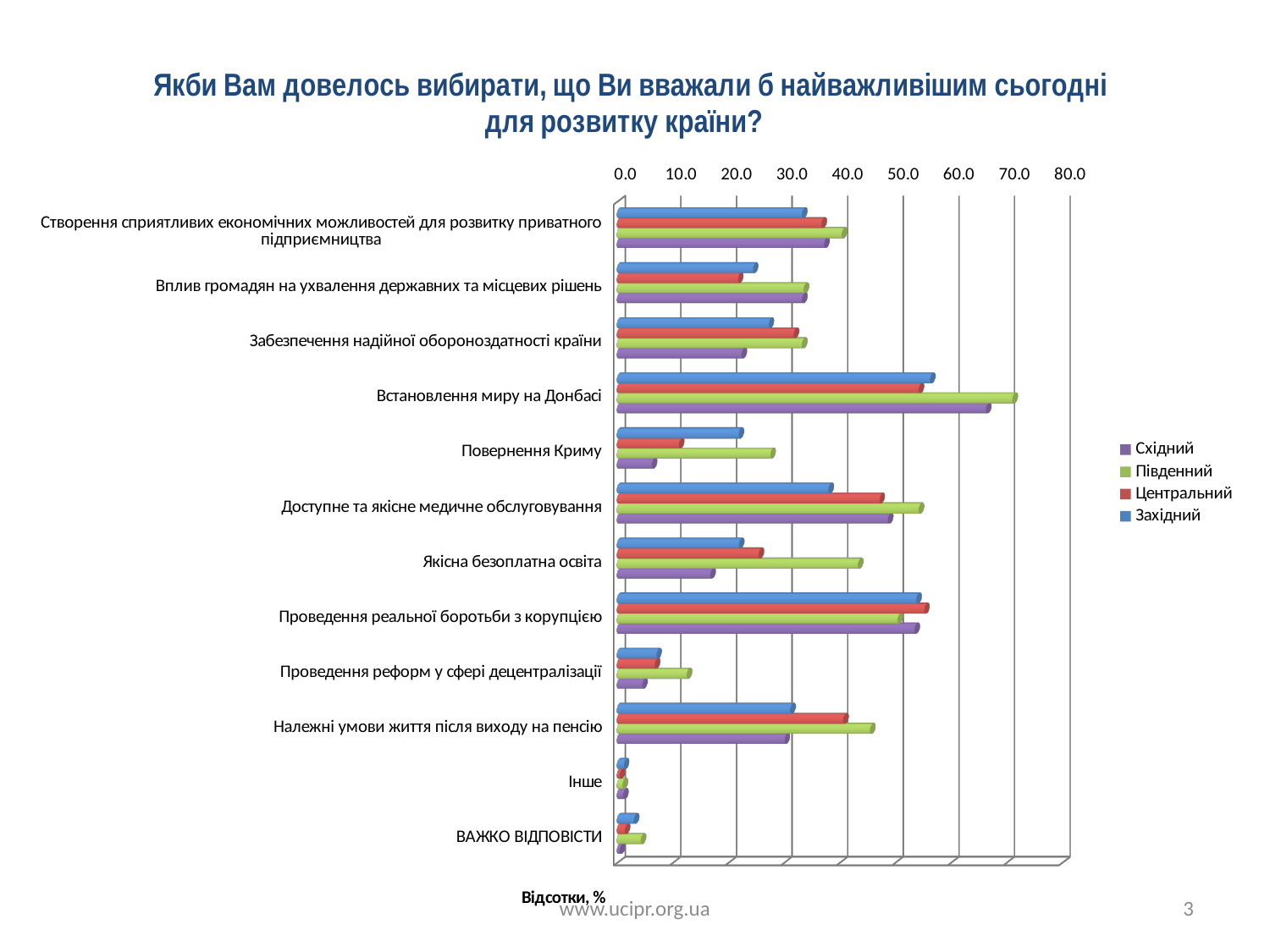
Which series has the highest value for 'Повернення Криму'? Південний Which series has the lowest value for 'Повернення Криму'? Східний What kind of chart is shown on the slide? Bar chart Is the Східний value for 'Проведення реформ у сфері децентралізації' greater or less than 10.0? less Is the Південний value for 'Встановлення миру на Донбасі' greater or less than 60.0? greater What label is shown on the horizontal axis of the chart? Відсотки, % Which category has the highest value for the Південний series? Встановлення миру на Донбасі How many categories are plotted on the chart? 12 Which category has the highest value for the Східний series? Встановлення миру на Донбасі For 'Якісна безоплатна освіта', which is larger: the Південний value or the Східний value? Південний How many series does the legend list? 4 For 'Вплив громадян на ухвалення державних та місцевих рішень', which is larger: the Західний value or the Південний value? Південний